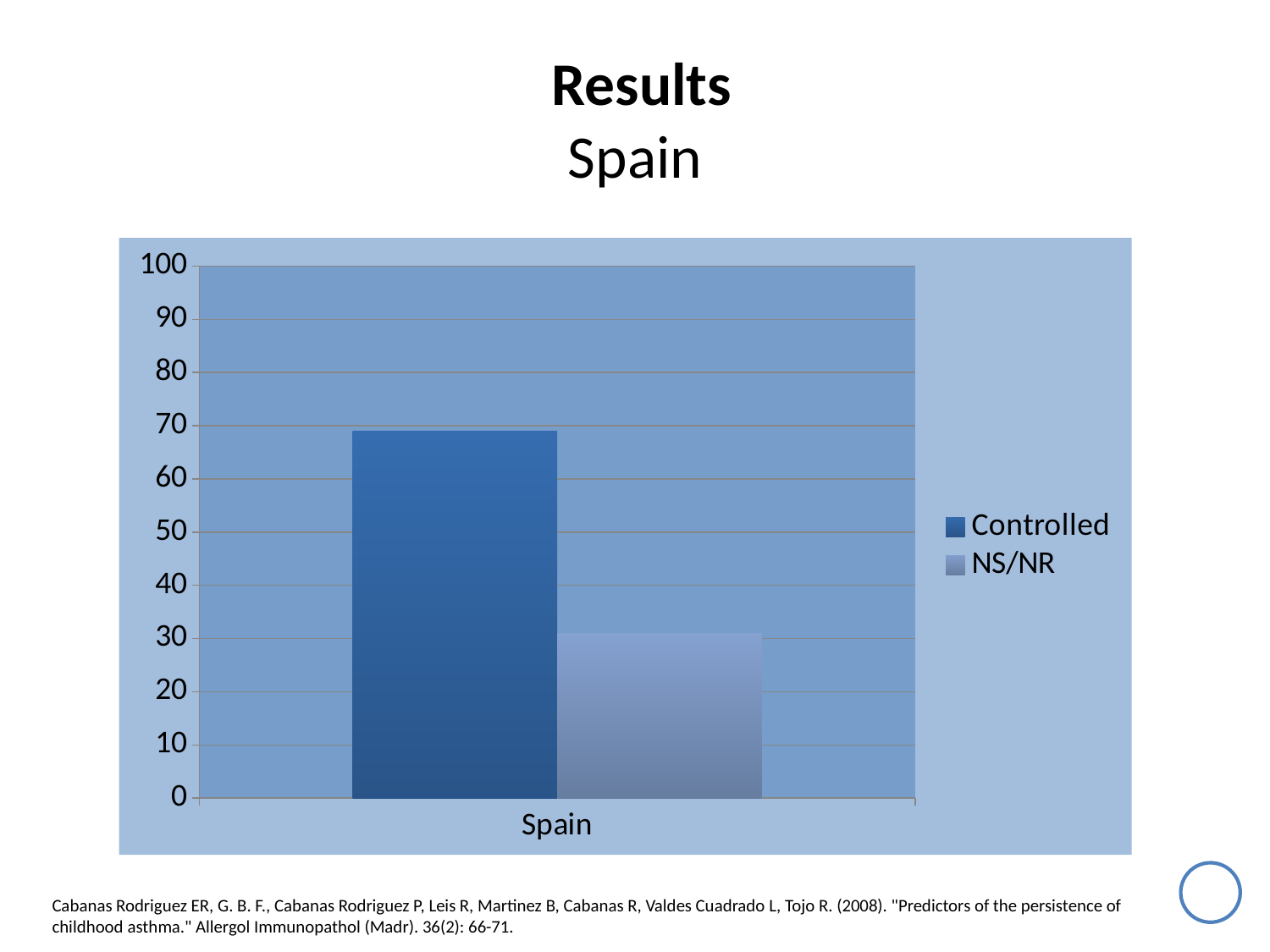
How many series does the chart legend list? 2 What kind of chart is shown on the slide? bar chart Which series has the lowest value in the chart? NS/NR What is the category label on the x axis of the chart? Spain Is the value for NS/NR greater or less than 20? greater What are the two series named in the chart legend? Controlled and NS/NR Is the value for NS/NR greater or less than 40? less Is the value for Controlled greater or less than 60? greater Which series has the highest value in the chart? Controlled How many categories are shown on the x axis of the chart? 1 Which series has the taller bar, Controlled or NS/NR? Controlled